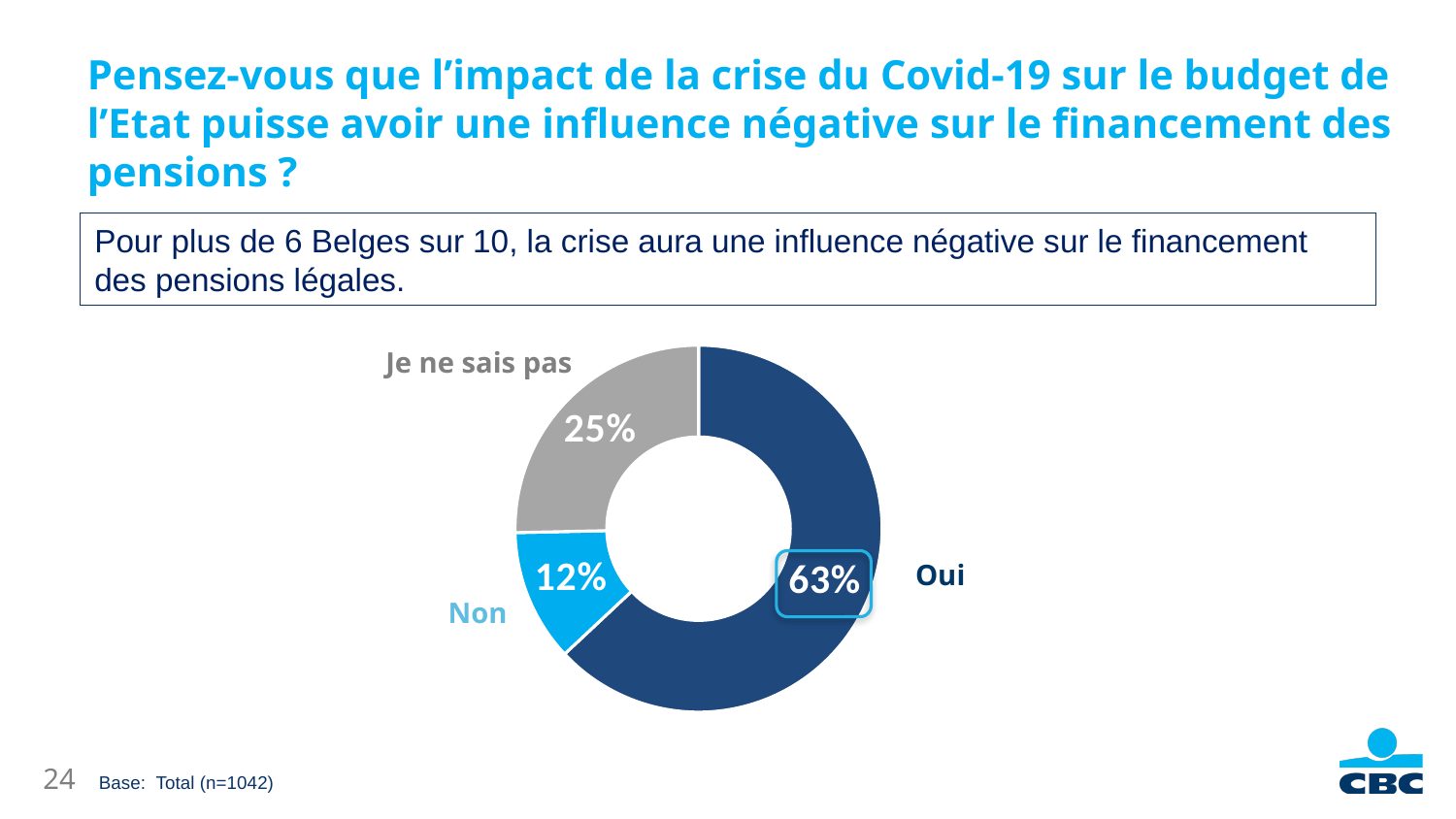
What percentage of respondents answered "Oui"? 63% Which response has the largest share of the chart? Oui What is the sample size (base) stated on the slide? n=1042 What percentage of respondents answered "Non"? 12% Which response has the smallest share of the chart? Non What colour is the "Non" slice of the chart? Light blue What kind of chart is shown on the slide? Pie chart (donut) What is the difference in percentage points between "Je ne sais pas" and "Non"? 13 How many categories are shown in the chart? 3 Which is larger, the share for "Je ne sais pas" or the share for "Non"? Je ne sais pas What percentage of respondents answered "Je ne sais pas"? 25% What is the difference in percentage points between "Oui" and "Non"? 51